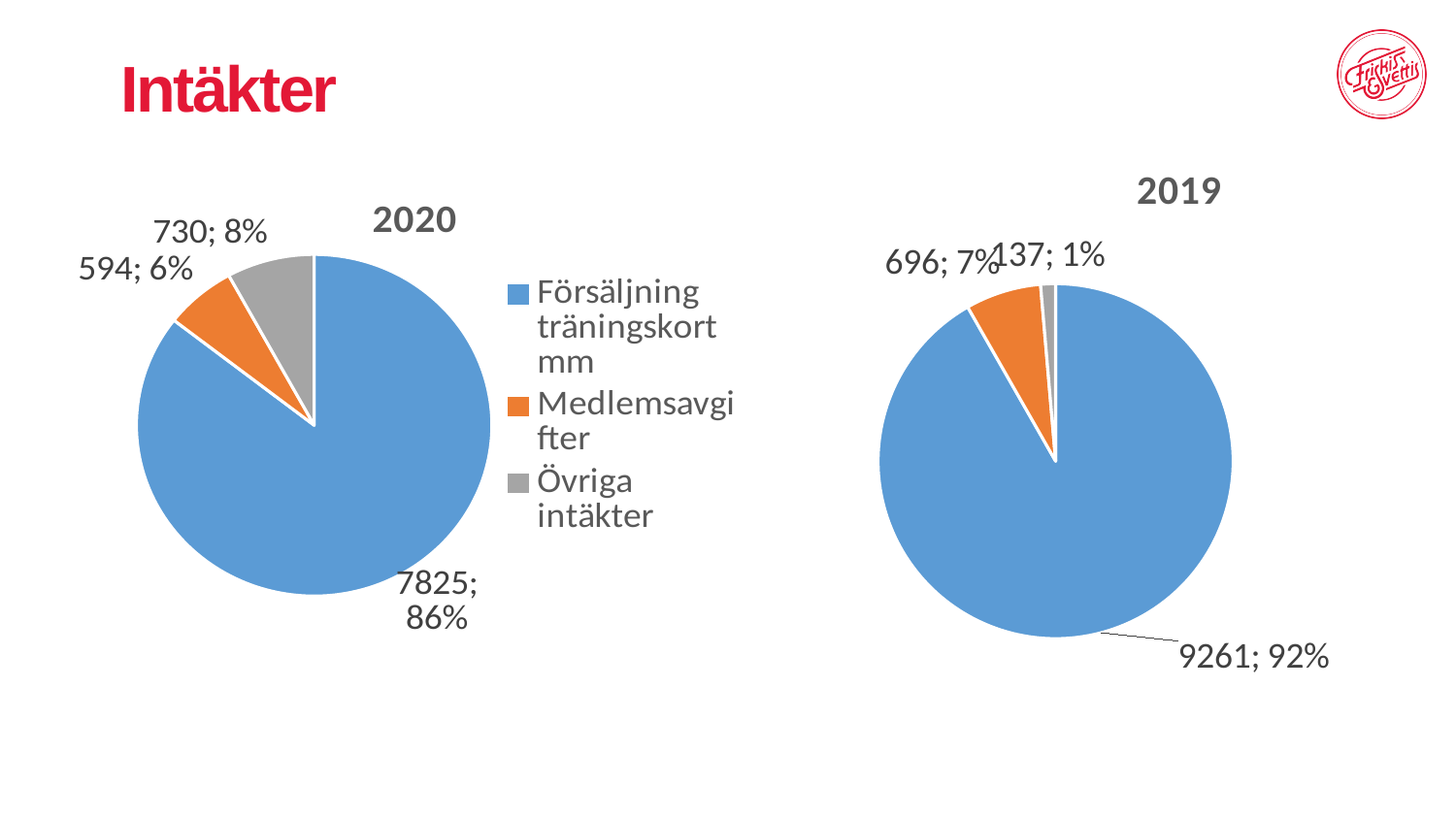
How many categories does the legend list? 3 In the 2020 chart, which category has the smallest slice? Medlemsavgifter In the 2020 chart, what is the value for Försäljning träningskort mm? 7825 In the 2019 chart, what share of the pie is Övriga intäkter? 1% In the 2019 chart, what is the value for Försäljning träningskort mm? 9261 In the 2019 chart, which category has the largest slice? Försäljning träningskort mm What kind of charts are shown on the slide? Pie charts In the 2020 chart, what is the value for Övriga intäkter? 730 In the 2019 chart, what is the value for Medlemsavgifter? 696 What is the difference between the Försäljning träningskort mm value in the 2019 chart and in the 2020 chart? 1436 In the 2020 chart, what share of the pie is Medlemsavgifter? 6% Which is larger: Övriga intäkter in the 2020 chart or Övriga intäkter in the 2019 chart? 2020